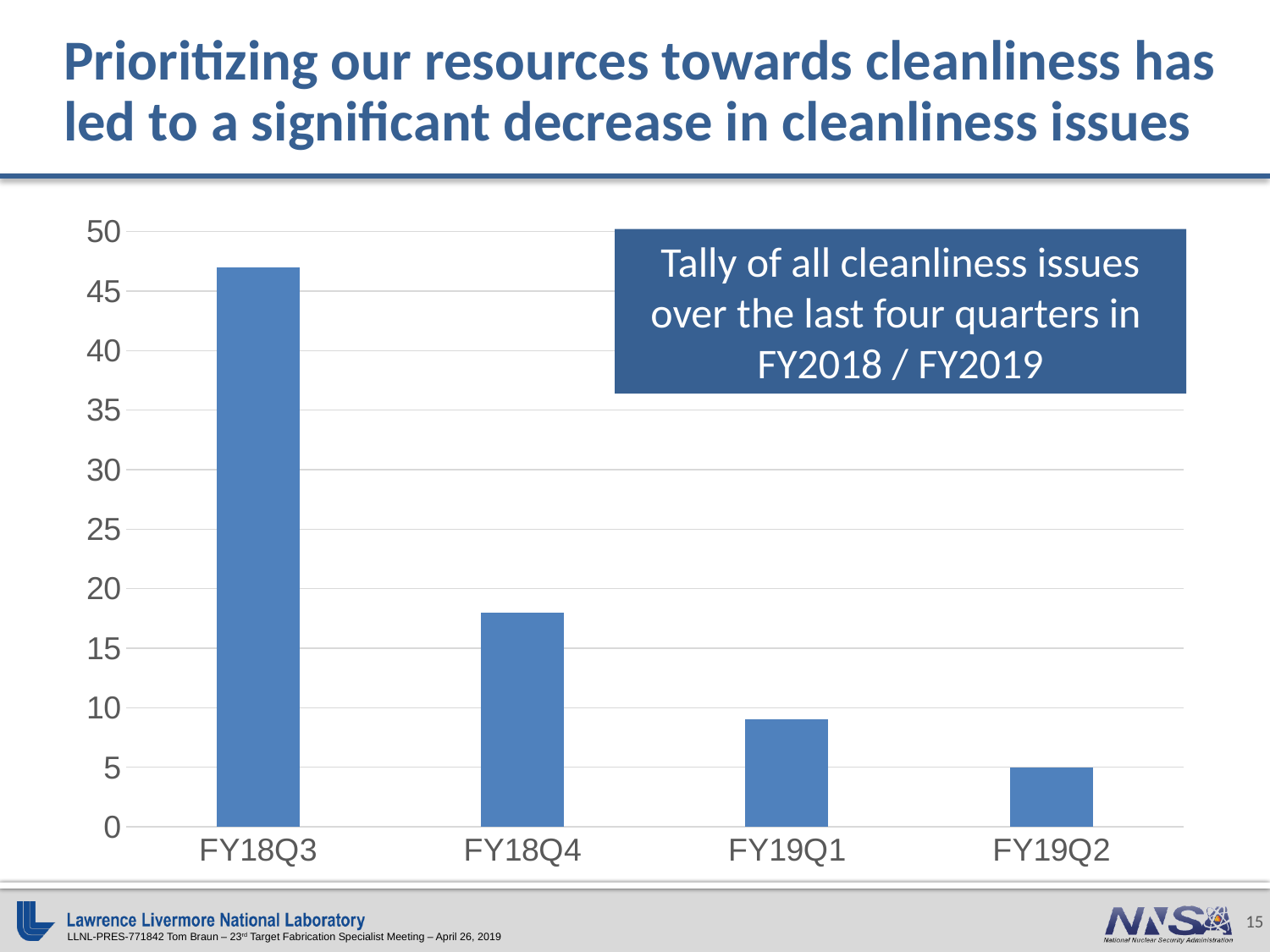
How many quarters are plotted on the x axis of the chart? 4 Is the value for FY18Q3 greater or less than 45? greater Is the value for FY18Q4 greater or less than 15? greater According to the text box on the chart, what does the chart tally? All cleanliness issues over the last four quarters in FY2018 / FY2019 Which quarter has the highest tally of cleanliness issues? FY18Q3 Do the values rise or fall from FY18Q3 to FY19Q2? fall Which has a larger value, FY18Q4 or FY19Q1? FY18Q4 What kind of chart is shown on the slide? bar chart What is the value for FY19Q2? 5 Is the value for FY18Q4 greater or less than 20? less Which quarter has the lowest tally of cleanliness issues? FY19Q2